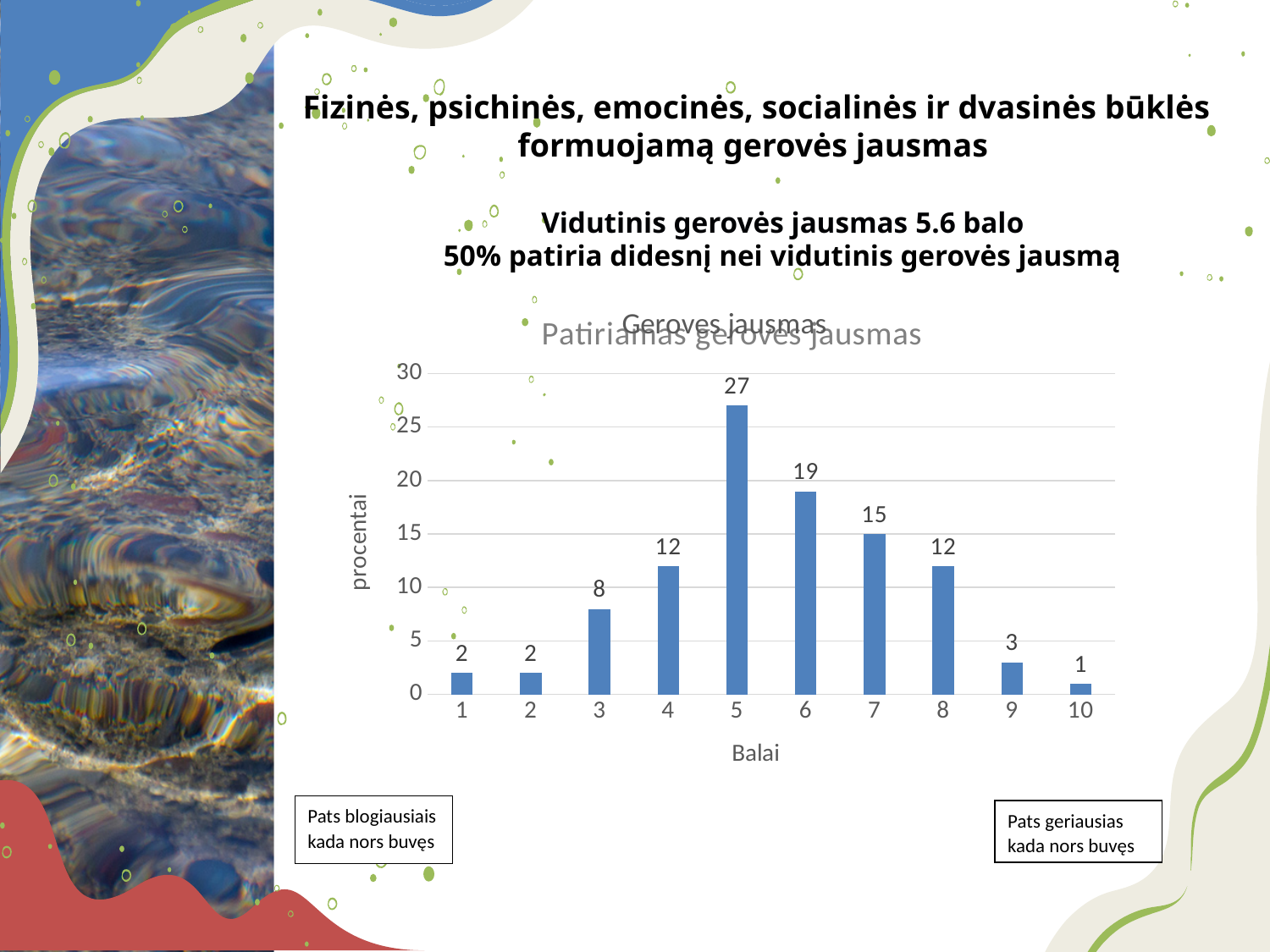
What is the value for score 5 (Balai 5)? 27 Which score (Balai) has the highest value? 5 What is the label of the y axis? procentai How many score categories are shown on the x axis? 10 Which has a larger value, score 6 or score 8? 6 Is the value for score 6 greater or less than 15? greater What is the difference between the values for score 5 and score 6? 8 What is the value for score 3 (Balai 3)? 8 What is the value for score 7 (Balai 7)? 15 Which score (Balai) has the lowest value? 10 What is the difference between the values for score 4 and score 9? 9 What kind of chart is shown on the slide? bar chart